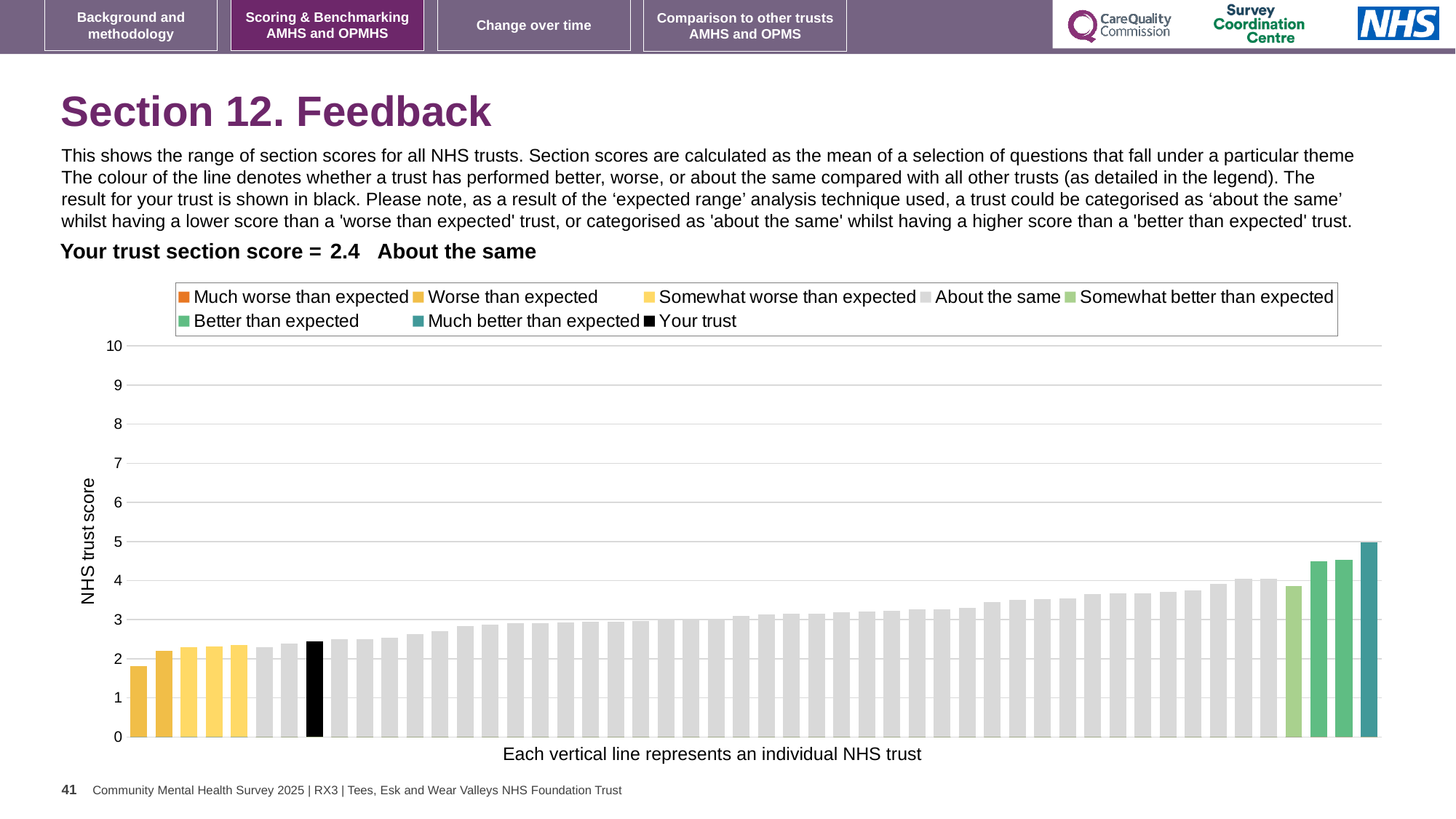
How many entries does the chart legend list? 8 Do the bar values rise or fall from left to right along the x axis? rise Which legend category does the tallest bar in the chart belong to? Much better than expected How many bars are coloured as 'Better than expected'? 2 What is the section score for your trust shown on the slide? 2.4 Is the value of the black 'Your trust' bar greater or less than 3? less Is the value of the shortest bar in the chart greater or less than 2? less Which legend category does the shortest bar in the chart belong to? Worse than expected How many bars are coloured as 'Somewhat worse than expected'? 3 Is the value of the tallest bar in the chart greater or less than 4? greater What kind of chart is shown on the slide? bar chart What is the label on the vertical axis of the chart? NHS trust score